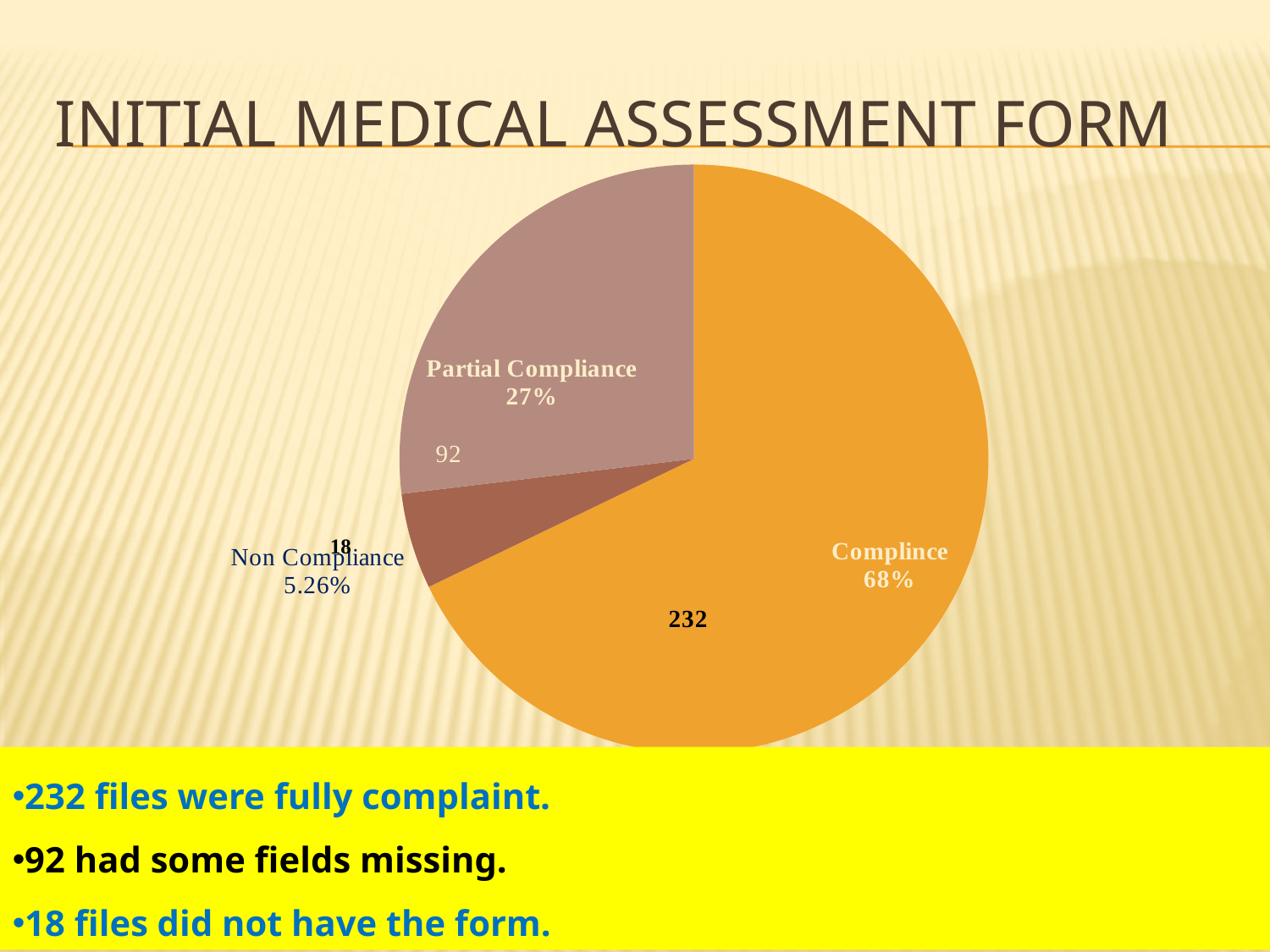
Which slice of the pie chart is the largest? Complince Which slice of the pie chart is the smallest? Non Compliance What is the value shown for the Complince slice? 232 What kind of chart is shown on the slide? pie chart What is the value shown for the Non Compliance slice? 18 What percentage share is shown for the Complince slice? 68% What is the difference between the Complince value and the Partial Compliance value? 140 What is the value shown for the Partial Compliance slice? 92 How many slices does the pie chart have? 3 What percentage share is shown for the Partial Compliance slice? 27% Which is larger, the Partial Compliance value or the Non Compliance value? Partial Compliance What percentage share is shown for the Non Compliance slice? 5.26%